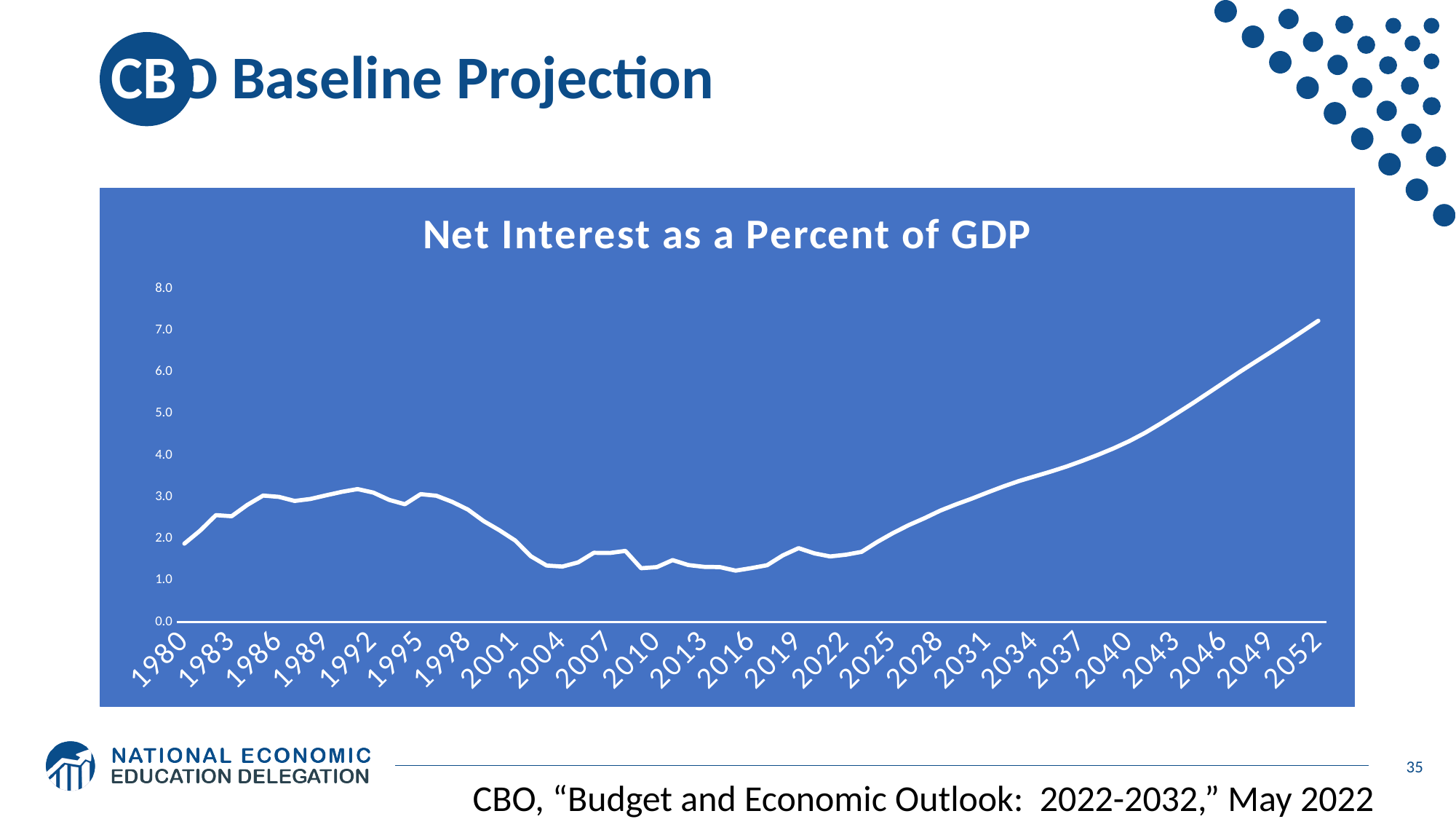
Which year on the x axis has the highest value for net interest as a percent of GDP? 2052 Is the value for 2016 greater or less than 2.0? less What is the title of the chart? Net Interest as a Percent of GDP Which has the larger value, 1980 or 2052? 2052 Which has the larger value, 1986 or 2016? 1986 Do the values rise or fall along the x axis from 1992 to 2004? fall Do the values rise or fall along the x axis from 2025 to 2052? rise Is the value for 2052 greater or less than 6.0? greater Is the value for 2004 greater or less than 2.0? less What kind of chart is shown on the slide? line chart